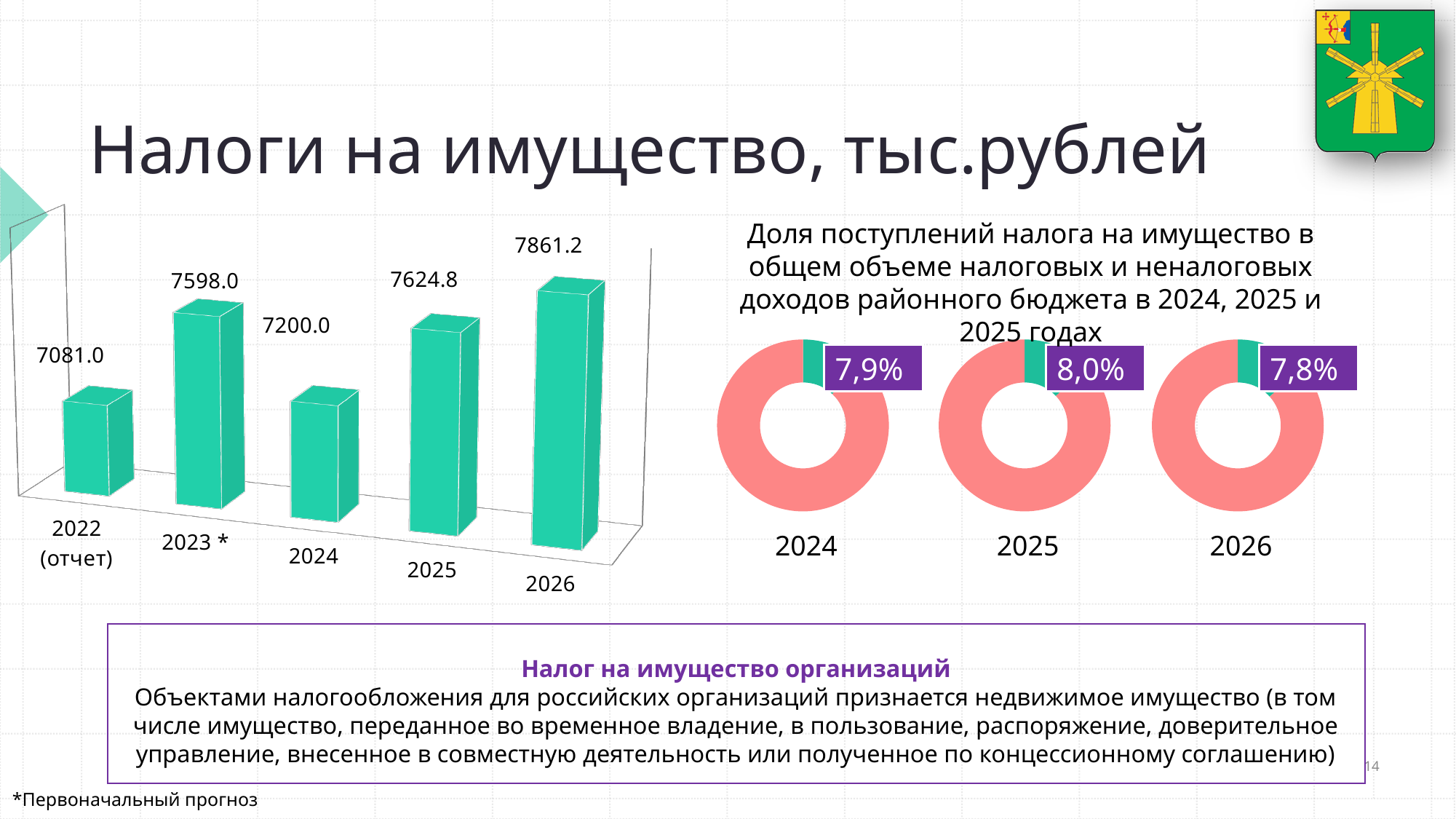
How many bars are in the bar chart on the left? 5 In the bar chart on the left, which year has the lowest value? 2022 (отчет) In the bar chart on the left, which is larger: the value for 2023 * or the value for 2024? 2023 * What kind of chart is shown on the left of the slide? Bar chart In the donut chart labelled 2026 on the right, what share is shown for the property tax? 7,8% In the bar chart on the left, which year has the highest value? 2026 In the bar chart on the left, what is the value for 2022 (отчет)? 7081.0 In the bar chart on the left, what is the difference between the values for 2026 and 2025? 236.4 Among the three donut charts on the right, which year shows the highest share? 2025 In the bar chart on the left, what is the value for 2025? 7624.8 In the donut chart labelled 2025 on the right, what share is shown for the property tax? 8,0% In the bar chart on the left, what is the value for 2024? 7200.0